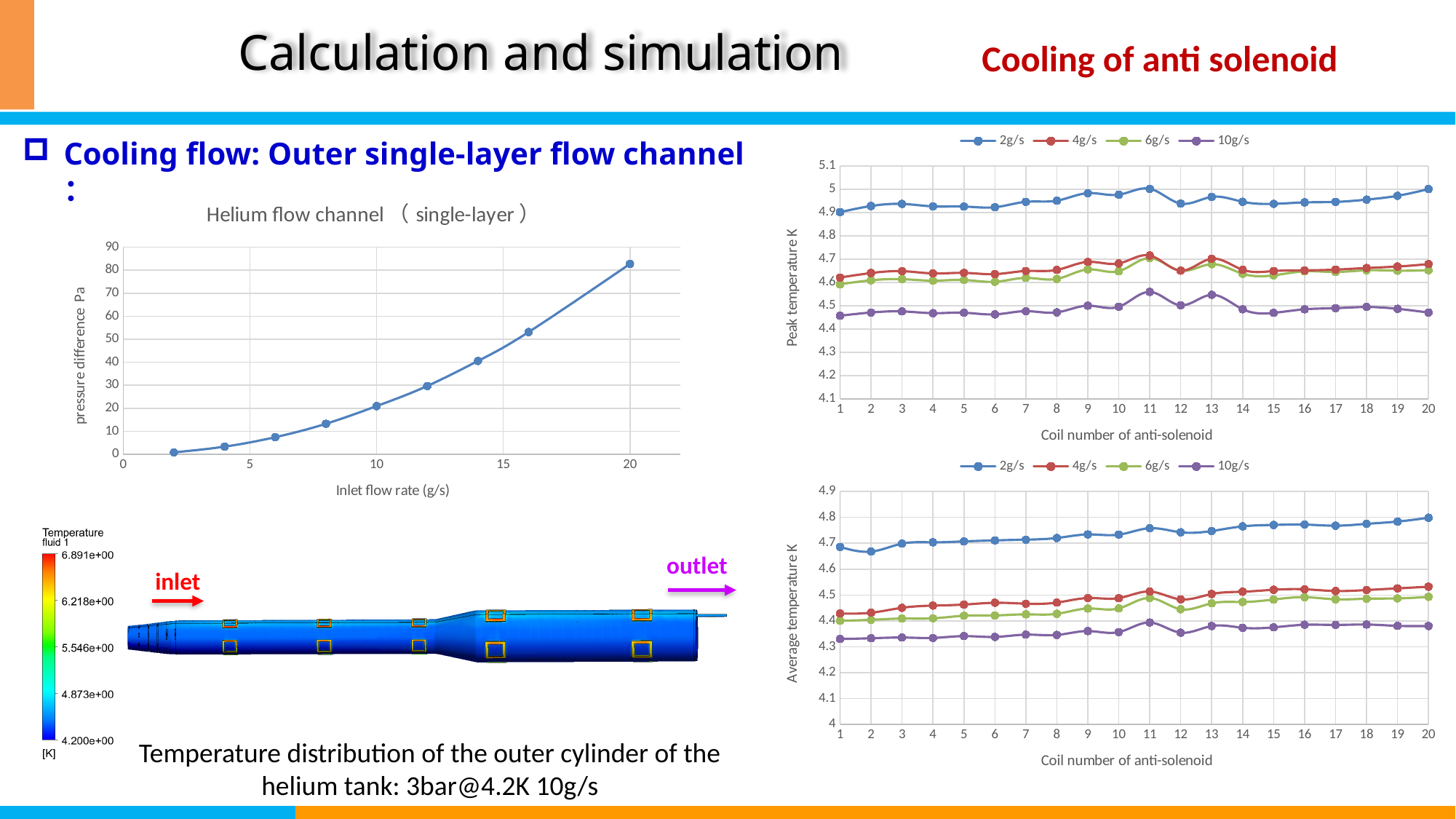
What kind of chart is the 'Helium flow channel (single-layer)' chart? line chart In the 'Helium flow channel (single-layer)' chart, does the pressure difference rise or fall as the inlet flow rate increases? rise In the 'Helium flow channel (single-layer)' chart, is the pressure difference at an inlet flow rate of 4 g/s greater or less than 10? less In the Average temperature K chart (bottom right), is the 10g/s value at coil number 1 greater or less than 4.4? less In the 'Helium flow channel (single-layer)' chart, is the pressure difference at an inlet flow rate of 20 g/s greater or less than 70? greater In the Peak temperature K chart (top right), which series has the lowest peak temperature across the coils? 10g/s In the 'Helium flow channel (single-layer)' chart, how many data points are plotted? 9 In the Peak temperature K chart (top right), which series has the highest peak temperature across the coils? 2g/s In the Peak temperature K chart (top right), how many series does the legend list? 4 In the Average temperature K chart (bottom right), how many coil numbers are shown on the x axis? 20 In the 'Helium flow channel (single-layer)' chart, what is the x-axis title? Inlet flow rate (g/s)